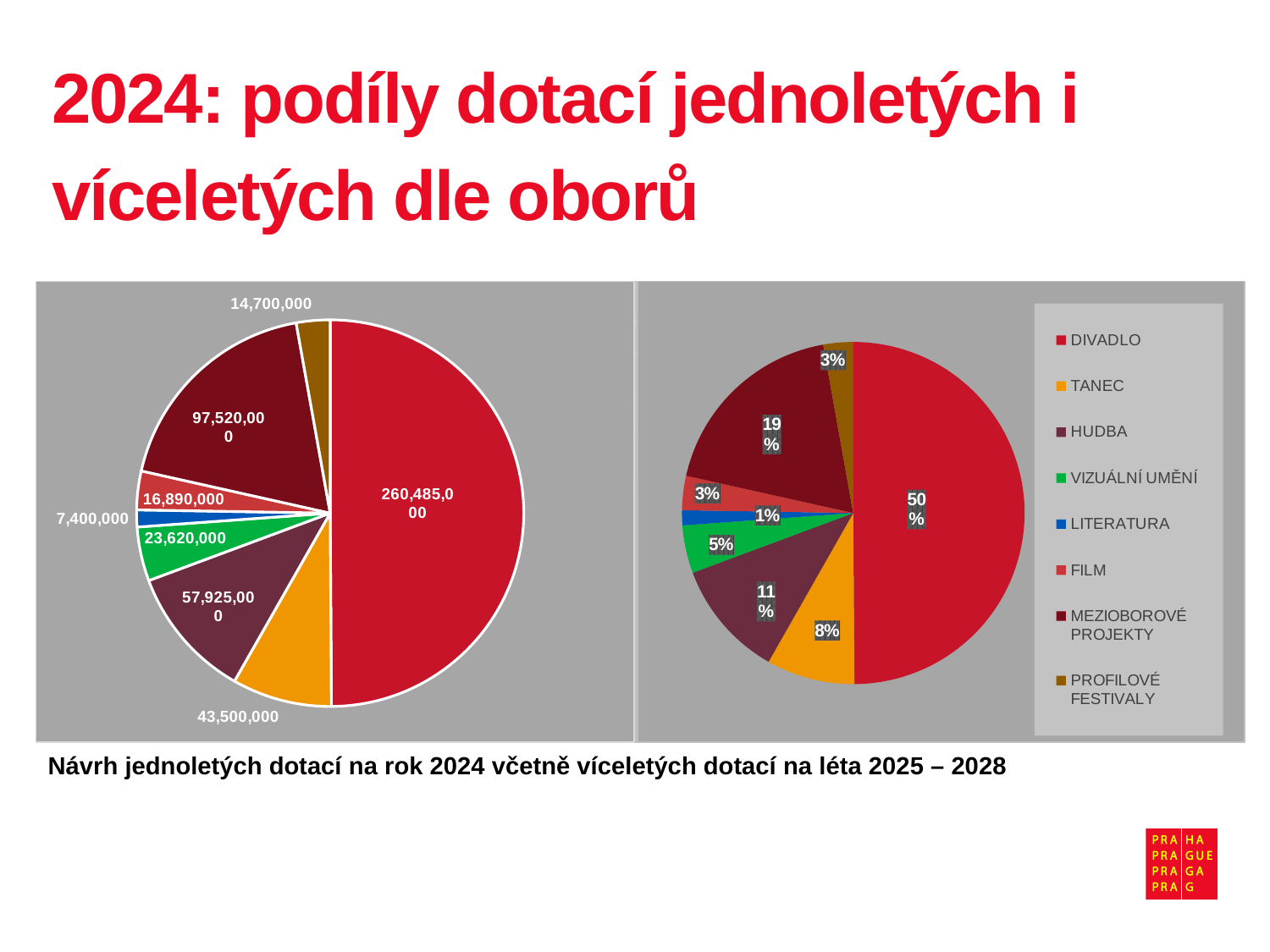
In the right pie chart, which category has the smallest share? LITERATURA In the right pie chart, what share does DIVADLO have? 50% In the left pie chart, which is larger: the slice labelled 43,500,000 or the slice labelled 23,620,000? 43,500,000 In the left pie chart, what is the value of the largest slice? 260,485,000 In the left pie chart, what is the value of the smallest slice? 7,400,000 In the right pie chart, what share does LITERATURA have? 1% In the right pie chart, what share does HUDBA have? 11% How many entries does the legend of the right pie chart list? 8 In the right pie chart, which category has the largest share? DIVADLO What kind of charts are shown on the slide? Pie charts In the left pie chart, what is the difference between the slice labelled 97,520,000 and the slice labelled 57,925,000? 39,595,000